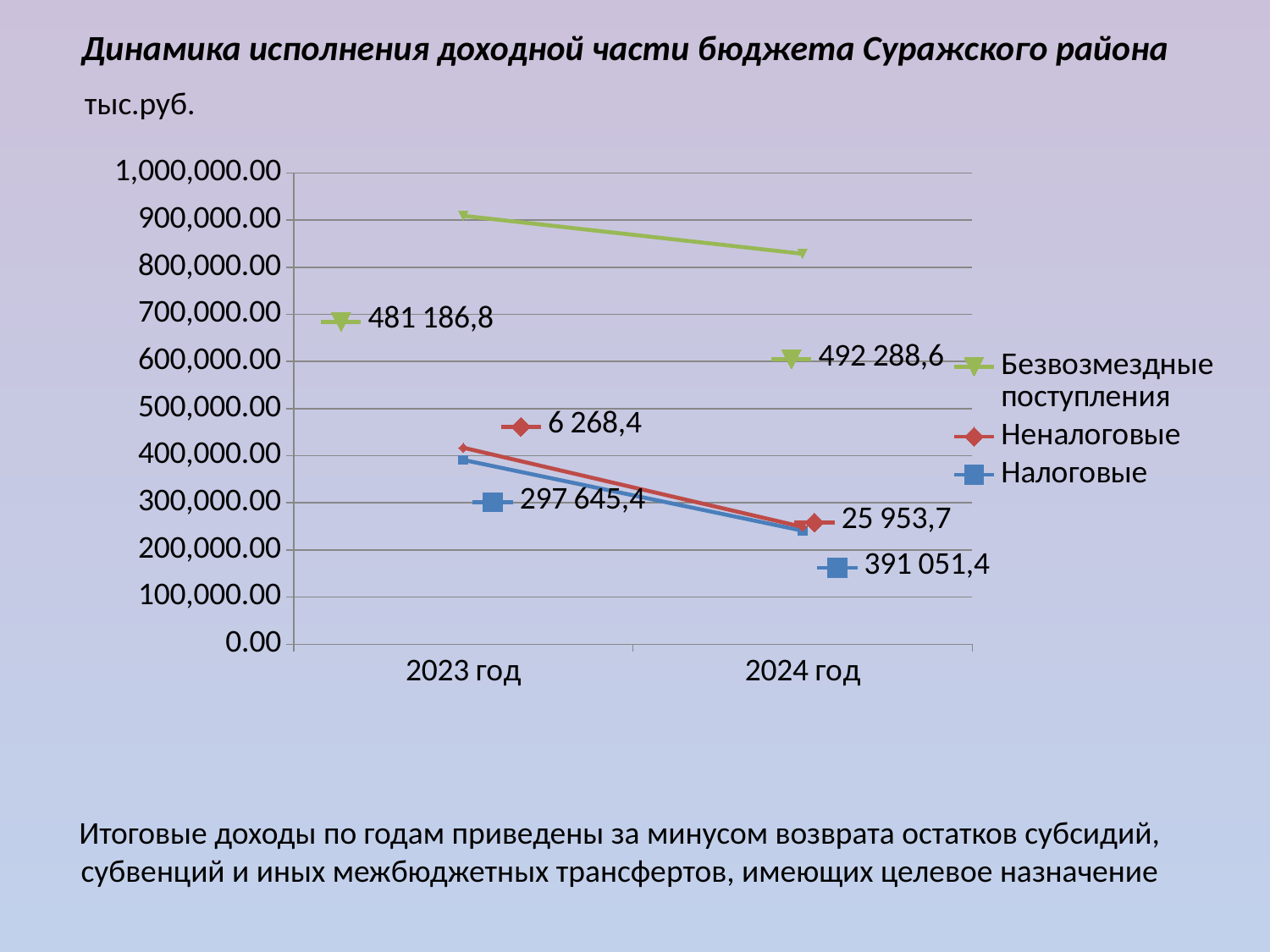
How many series does the legend list? 3 How many years are shown on the x axis? 2 Is the value for Безвозмездные поступления in 2024 год greater or less than 900,000.00? less What kind of chart is shown on the slide? line chart Is the value for Налоговые in 2024 год greater or less than 300,000.00? less Which series has the highest values in both years? Безвозмездные поступления Which is larger in 2024 год: Безвозмездные поступления or Неналоговые? Безвозмездные поступления Does the Налоговые line rise or fall from 2023 год to 2024 год? fall What unit of measurement is stated above the chart? тыс.руб.